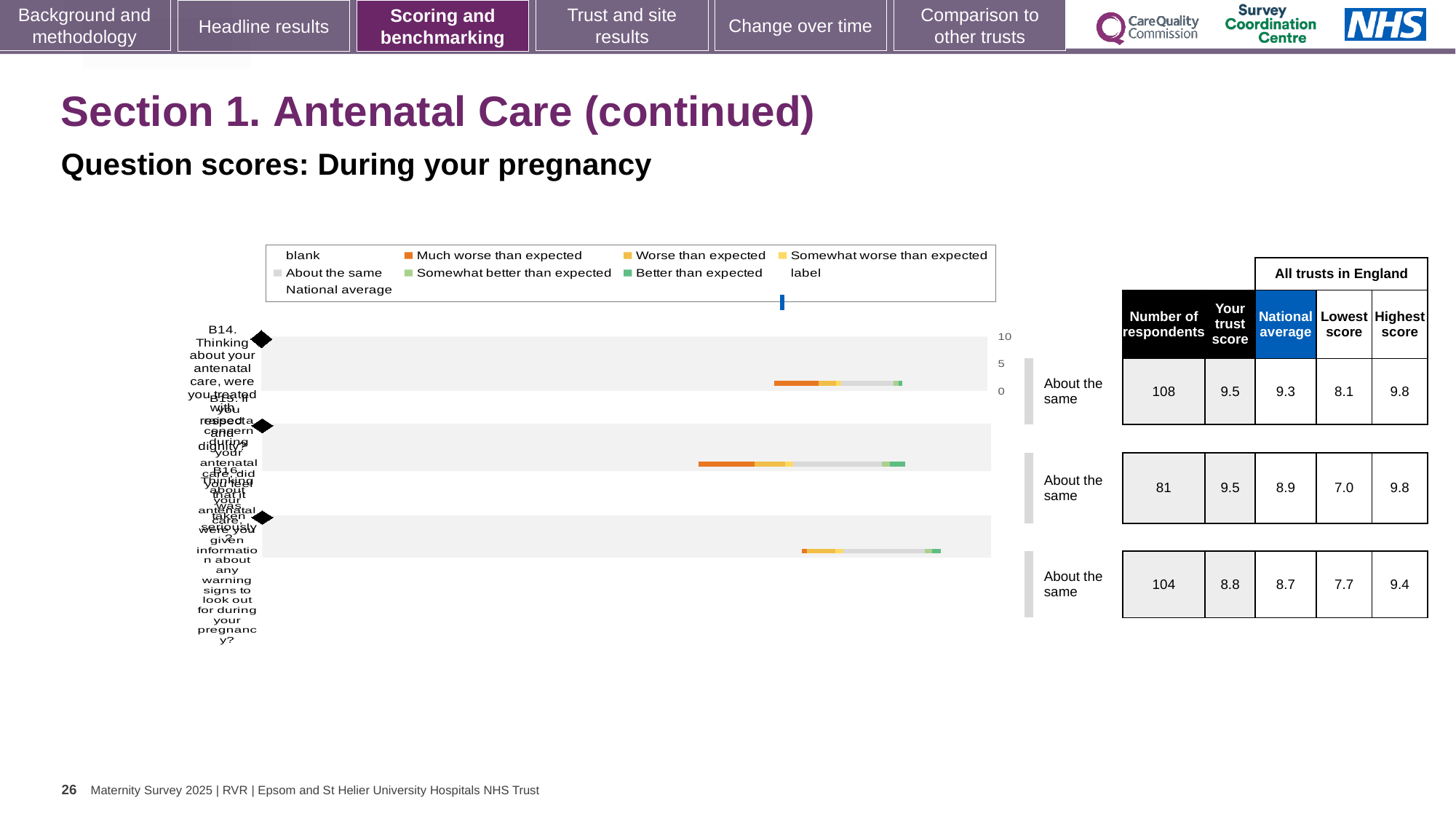
In the table next to the chart, what is the trust score for the top question (B14)? 9.5 What kind of chart is shown on the slide? bar chart In the table next to the chart, what is the number of respondents for the top question (B14, treated with respect and dignity)? 108 How many questions (bars) are plotted in the chart? 3 In the table next to the chart, what is the lowest score for the bottom question (B16, warning signs)? 7.7 What is the maximum value shown on the chart's score axis? 10 What benchmark category is shown for all three questions? About the same In the table next to the chart, what is the national average for the second question? 8.9 What is the difference between the trust score and the national average for the second question? 0.6 Which of the three questions has the highest number of respondents? B14 (top question), 108 For the bottom question (B16), which is larger: the trust score or the national average? trust score (8.8) Which colour in the legend represents 'Much worse than expected'? orange